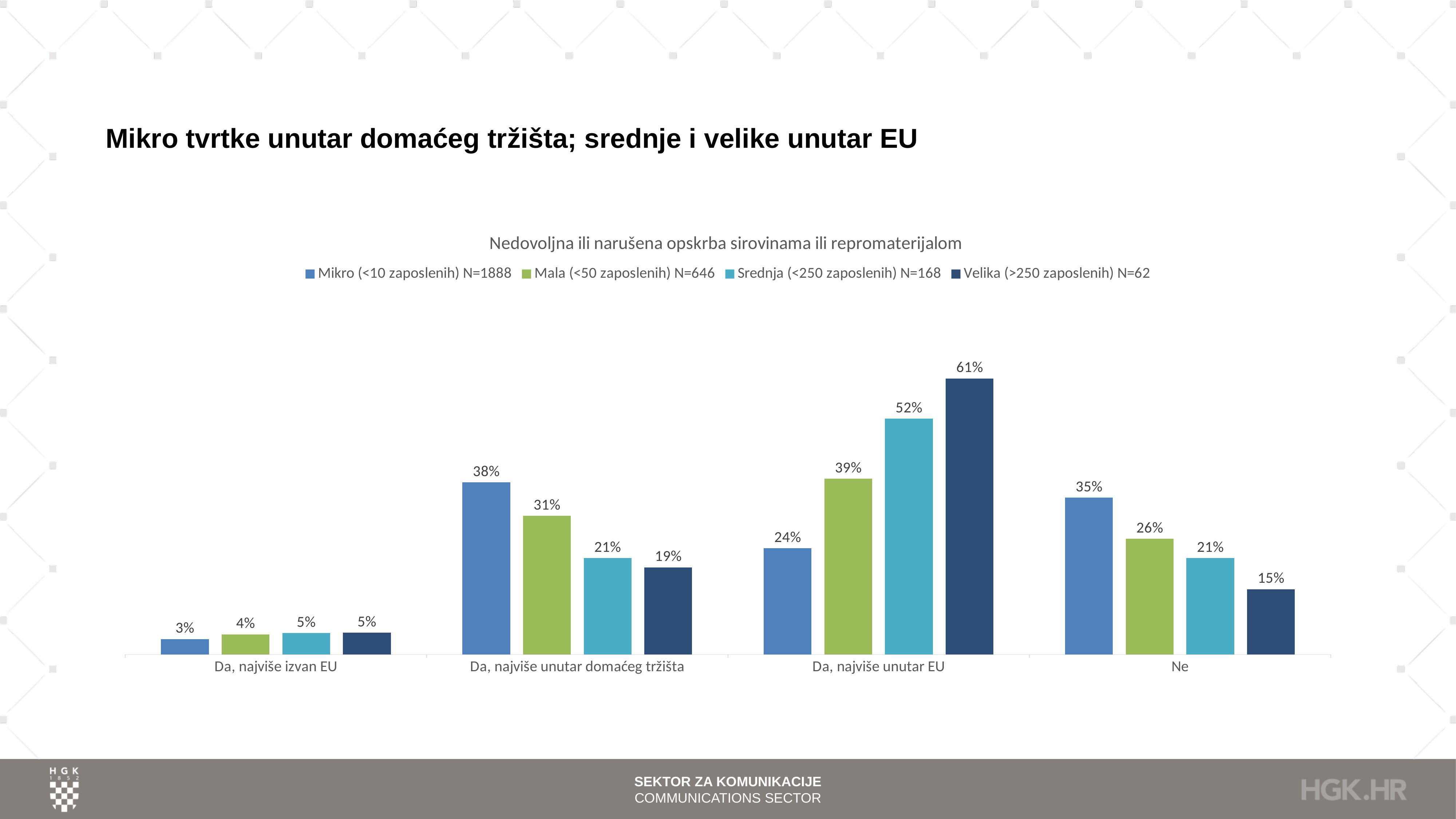
Which is larger: the Mikro value for "Da, najviše unutar domaćeg tržišta" or the Mikro value for "Ne"? Da, najviše unutar domaćeg tržišta What type of chart is shown on the slide? Bar chart What is the value for Mikro (<10 zaposlenih) in the category "Da, najviše unutar domaćeg tržišta"? 38% How many categories are shown on the x axis? 4 Which series has the highest value in the category "Da, najviše unutar EU"? Velika (>250 zaposlenih) N=62 What is the value for Velika (>250 zaposlenih) in the category "Da, najviše unutar EU"? 61% What is the difference between the Velika and Mikro values in the category "Da, najviše unutar EU"? 37% What is the value for Mala (<50 zaposlenih) in the category "Da, najviše izvan EU"? 4% How many series does the legend list? 4 Which series has the lowest value in the category "Ne"? Velika (>250 zaposlenih) N=62 What is the value for Srednja (<250 zaposlenih) in the category "Ne"? 21% What is the difference between the Mikro and Mala values in the category "Ne"? 9%